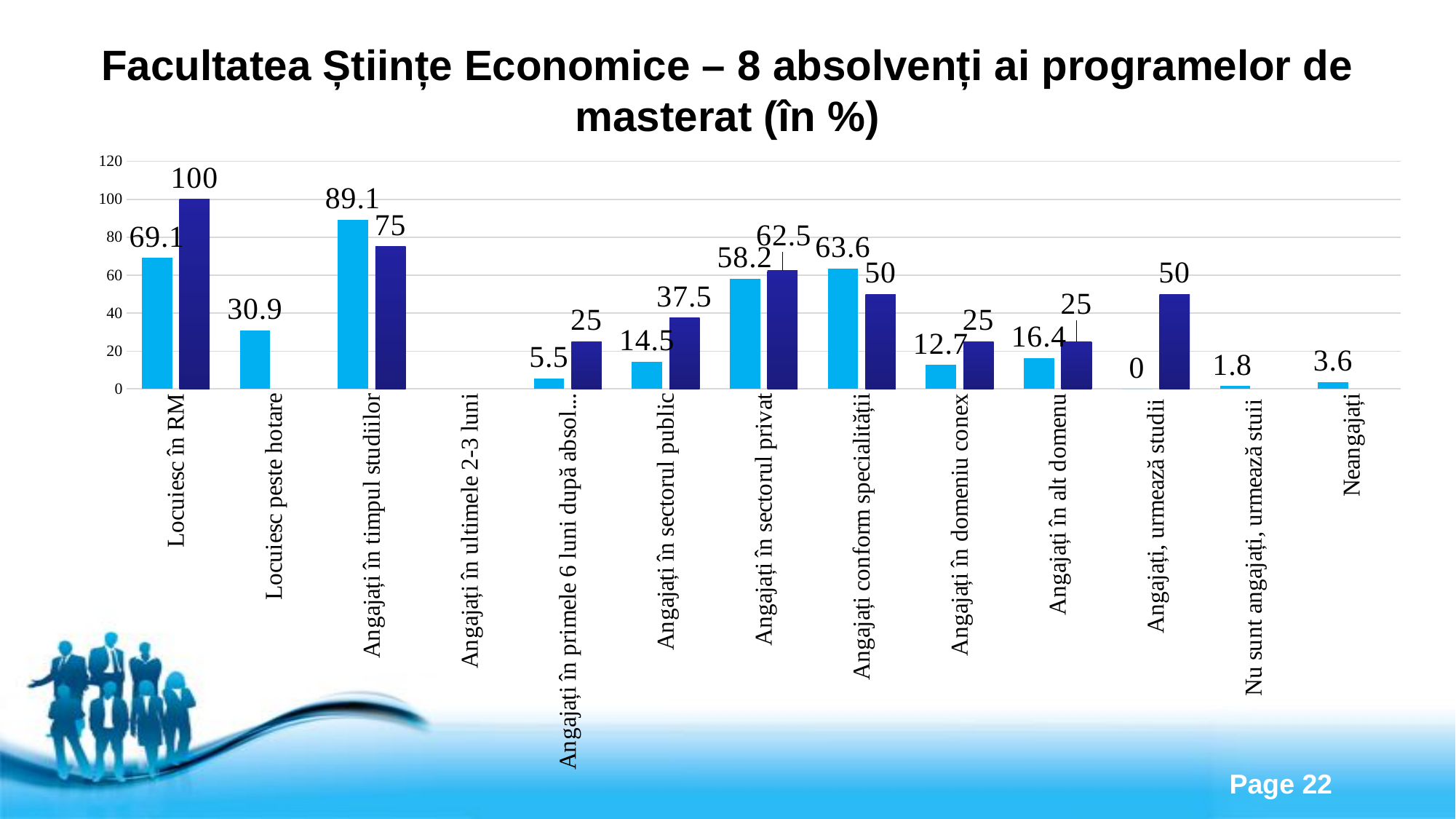
What is the value shown for "Neangajați"? 3.6 What is the value of the dark blue bar for "Angajați în sectorul public"? 37.5 How many categories are shown on the x axis of the chart? 13 Is the light blue value for "Locuiesc peste hotare" greater or less than 40? less What kind of chart is shown on the slide? bar chart Which is larger for "Angajați conform specialității": the light blue bar or the dark blue bar? the light blue bar Which category has the highest light blue bar? Angajați în timpul studiilor What is the value of the dark blue bar for "Locuiesc în RM"? 100 Which category has the highest dark blue bar? Locuiesc în RM What is the value of the light blue bar for "Locuiesc în RM"? 69.1 What is the value of the light blue bar for "Angajați în timpul studiilor"? 89.1 What is the difference between the dark blue and light blue bars for "Angajați în sectorul public"? 23